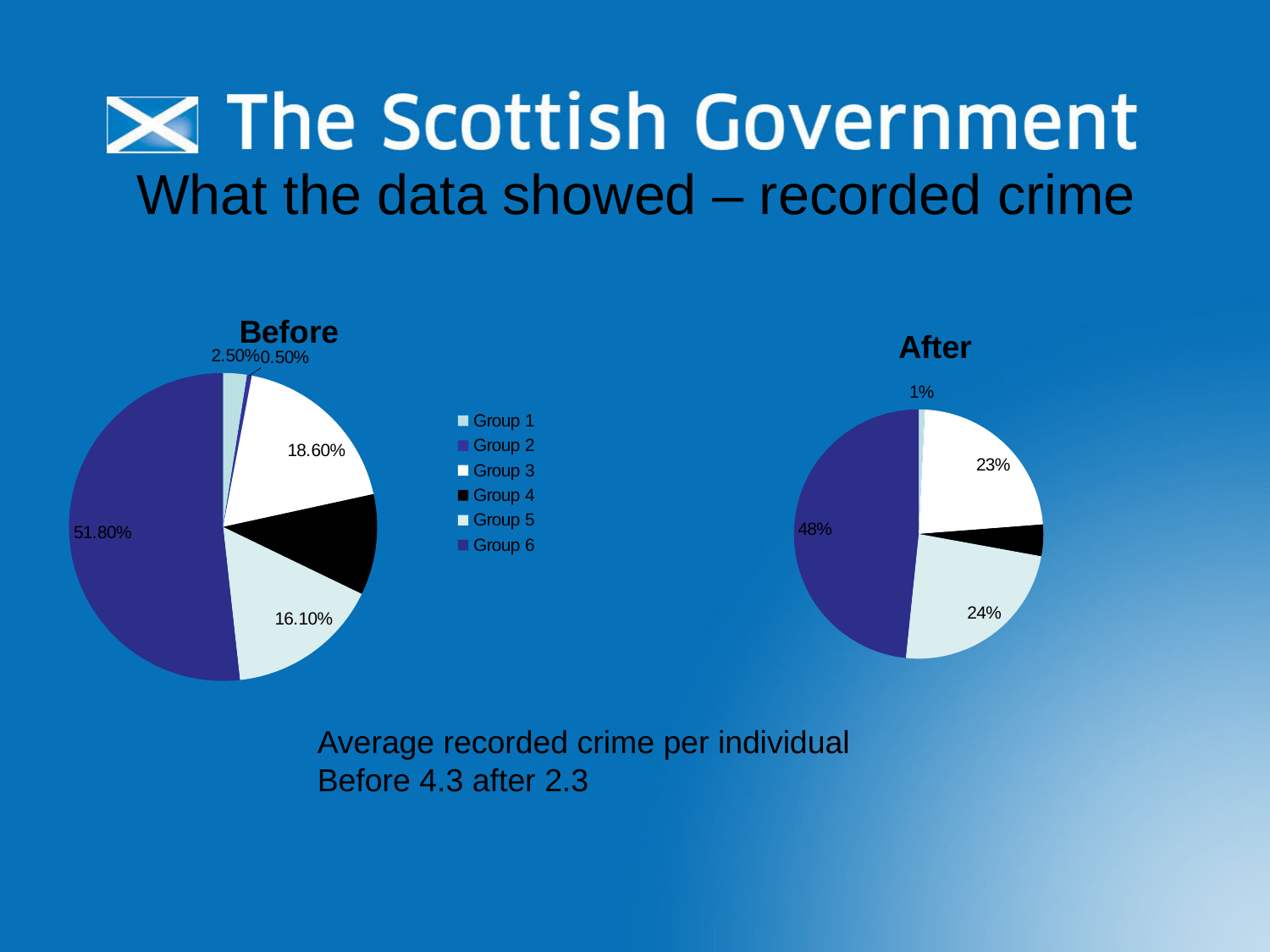
In the Before pie chart, what is the smallest labelled slice value? 0.50% In the After pie chart, what percentage is shown for Group 3? 23% In the After pie chart, what is the value of the largest slice? 48% What type of chart is used for the Before and After data? Pie chart In the After pie chart, what percentage is shown for Group 5? 24% In the Before pie chart, what percentage is shown for Group 3? 18.60% How many groups does the legend list? 6 In the After pie chart, which is larger, the Group 3 slice or the Group 5 slice? Group 5 In the Before pie chart, what is the difference between the Group 3 slice and the Group 5 slice? 2.50% In the Before pie chart, what is the value of the largest slice? 51.80% In the Before pie chart, what percentage is shown for Group 5? 16.10% In the After pie chart, what is the difference between the Group 6 slice and the Group 5 slice? 24%